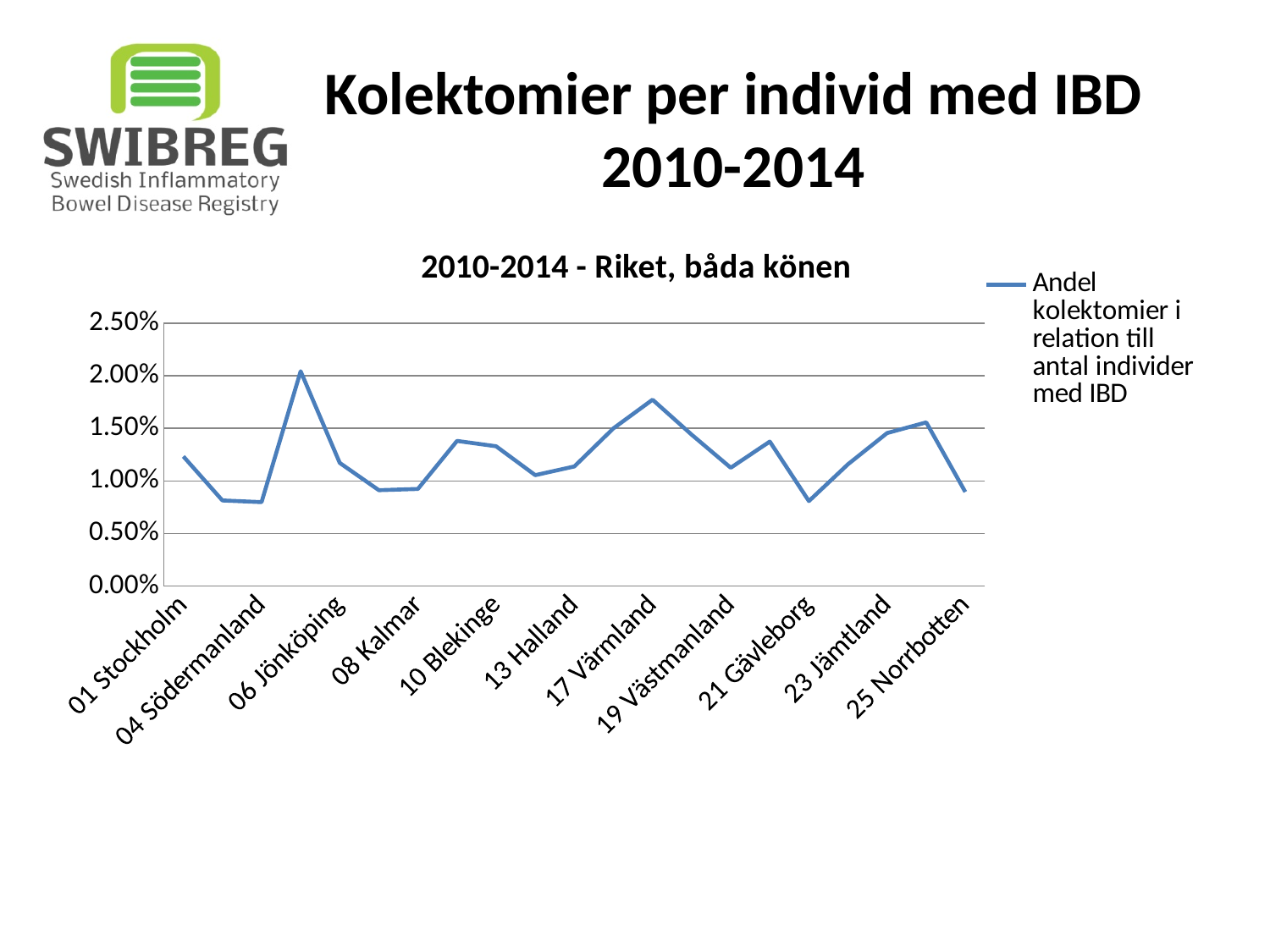
How many series does the chart legend list? 1 What is the legend entry for the plotted line? Andel kolektomier i relation till antal individer med IBD Is the value for 25 Norrbotten greater or less than 1.00%? less Is the value for 08 Kalmar greater or less than 1.00%? less Is the value for 17 Värmland greater or less than 1.50%? greater Which has the larger value, 04 Södermanland or 10 Blekinge? 10 Blekinge Which has the larger value, 17 Värmland or 21 Gävleborg? 17 Värmland What is the title of the chart? 2010-2014 - Riket, båda könen What kind of chart is shown on the slide? line chart